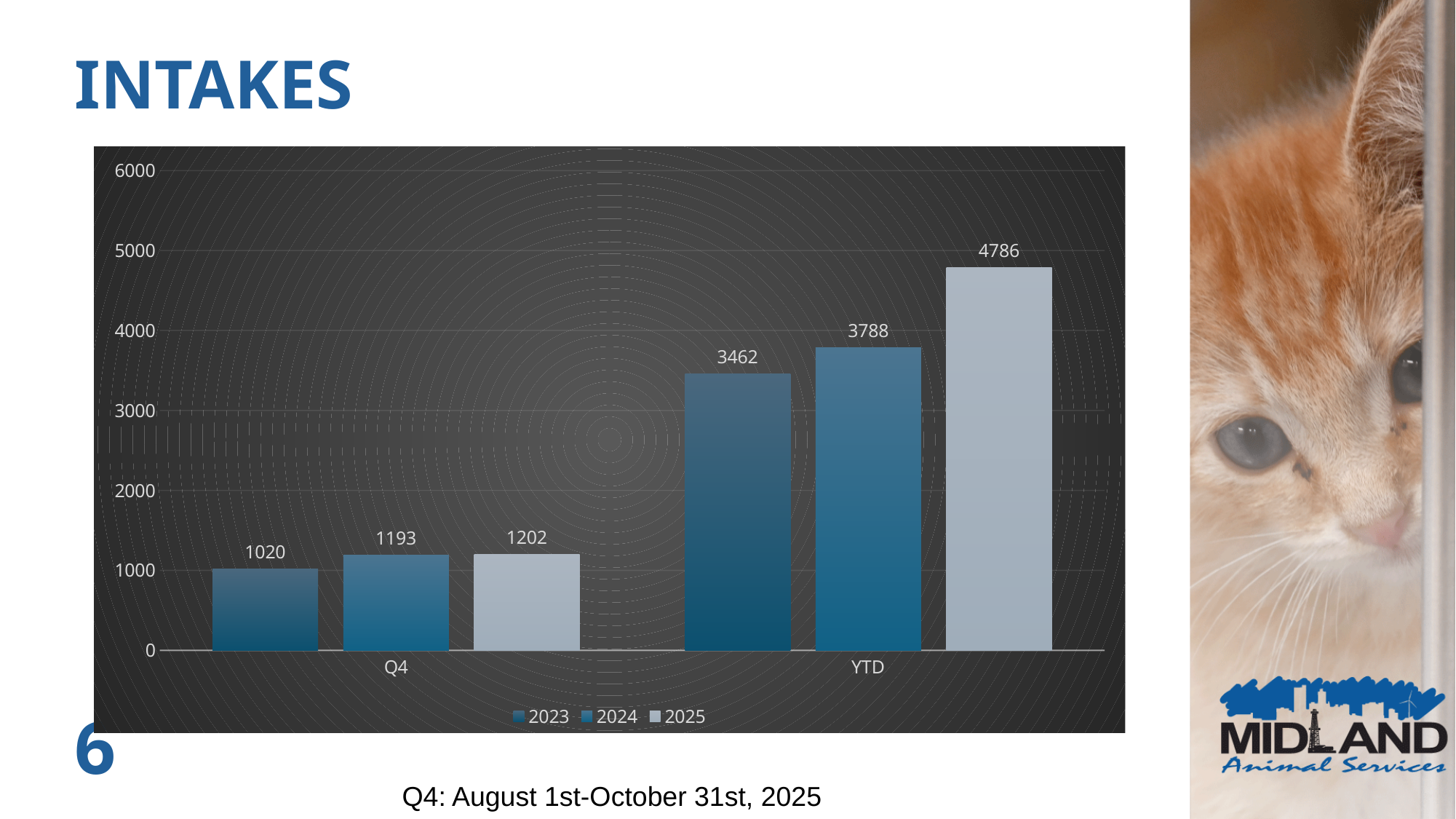
How many series does the legend list? 3 What is the title of the slide containing the chart? INTAKES Which is larger, the 2023 YTD value or the 2024 YTD value? 2024 YTD What kind of chart is shown on the slide? bar chart Is the 2023 YTD value greater or less than 3000? greater What is the difference between the 2024 and 2023 Q4 values? 173 Which year has the highest YTD value? 2025 What is the difference between the 2025 and 2024 YTD values? 998 What is the value for 2025 in YTD? 4786 What is the value for 2024 in Q4? 1193 Which year has the lowest Q4 value? 2023 What is the value for 2023 in Q4? 1020